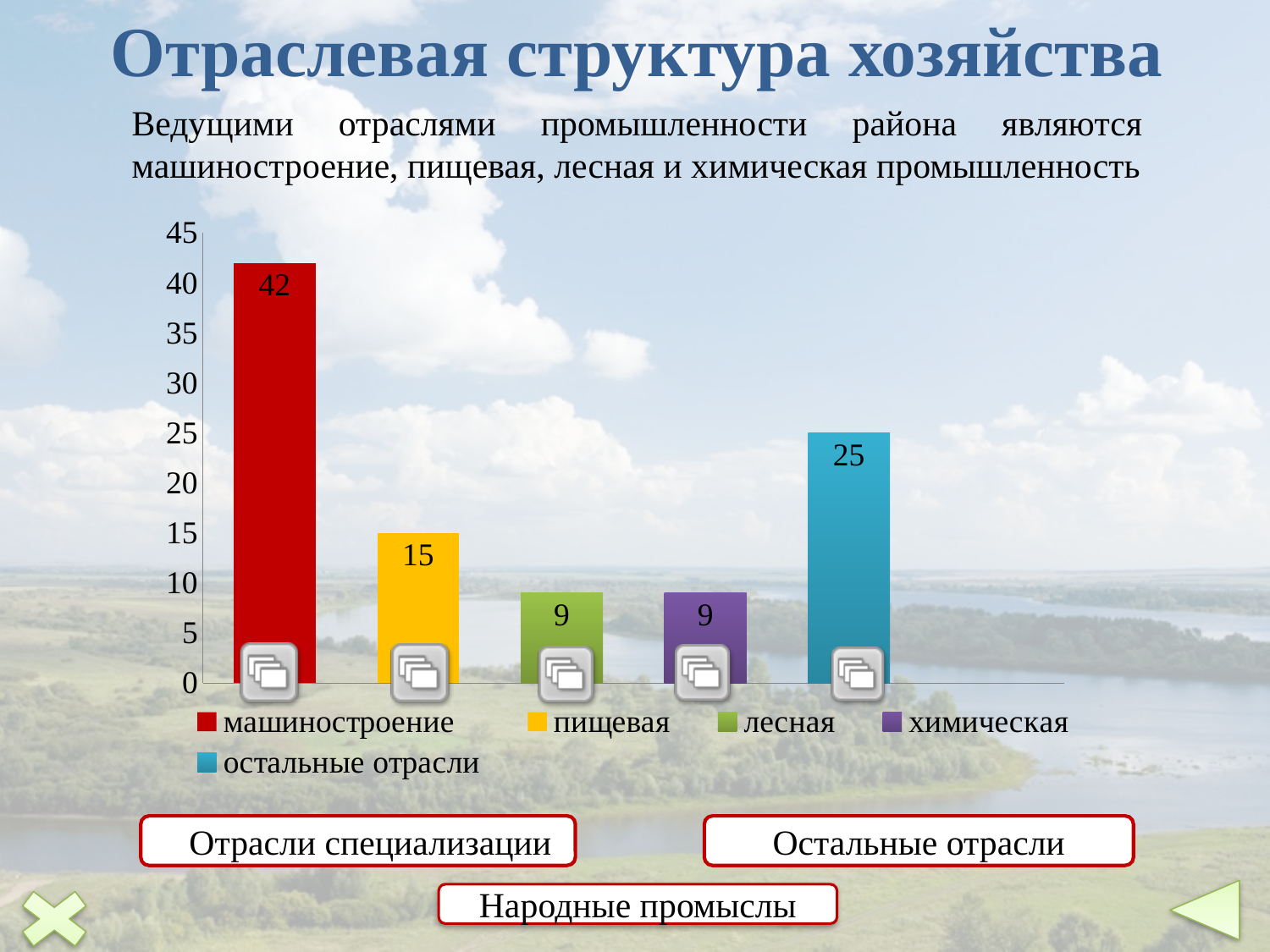
What kind of chart is shown on the slide? bar chart Which is larger, the value for пищевая or the value for остальные отрасли? остальные отрасли What is the value for пищевая? 15 What is the value for химическая? 9 What is the difference between the values for машиностроение and остальные отрасли? 17 Is the value for машиностроение greater or less than 40? greater How many entries does the legend list? 5 What is the value for остальные отрасли? 25 What is the value for машиностроение? 42 How many bars are plotted in the chart? 5 What is the difference between the values for пищевая and лесная? 6 Which category has the highest value? машиностроение